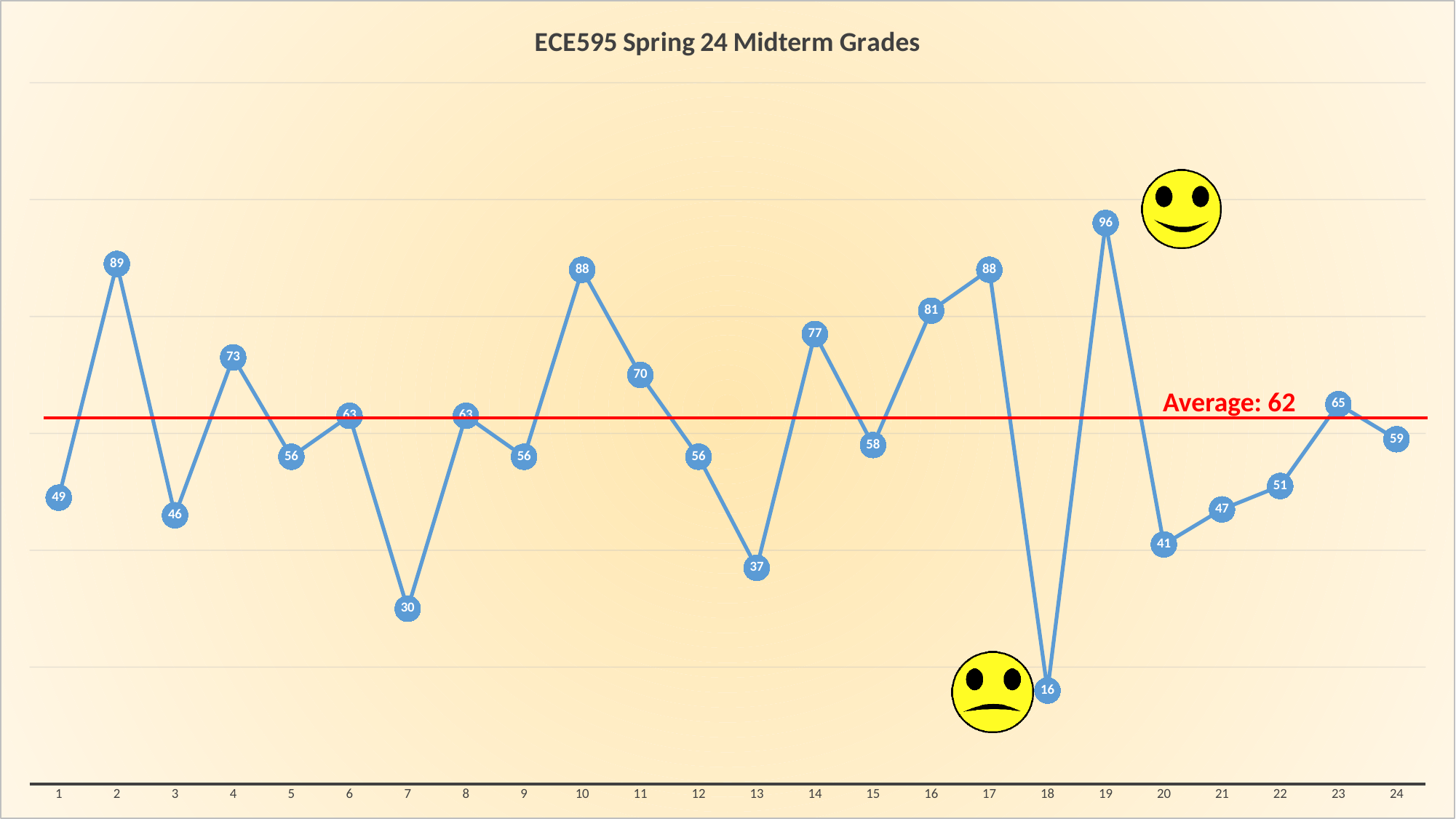
Which has the higher grade, student 7 or student 13? student 13 Which student number has the highest midterm grade? 19 What is the difference between the highest grade (student 19) and the lowest grade (student 18)? 80 What is the midterm grade for student 14? 77 What is the difference between the grades of student 2 and student 3? 43 What is the title of the chart? ECE595 Spring 24 Midterm Grades Which student number has the lowest midterm grade? 18 What average value is marked by the red horizontal line? 62 What is the midterm grade for student 19? 96 What type of chart is shown on the slide? line chart How many students' grades are plotted on the chart? 24 What is the midterm grade for student 7? 30